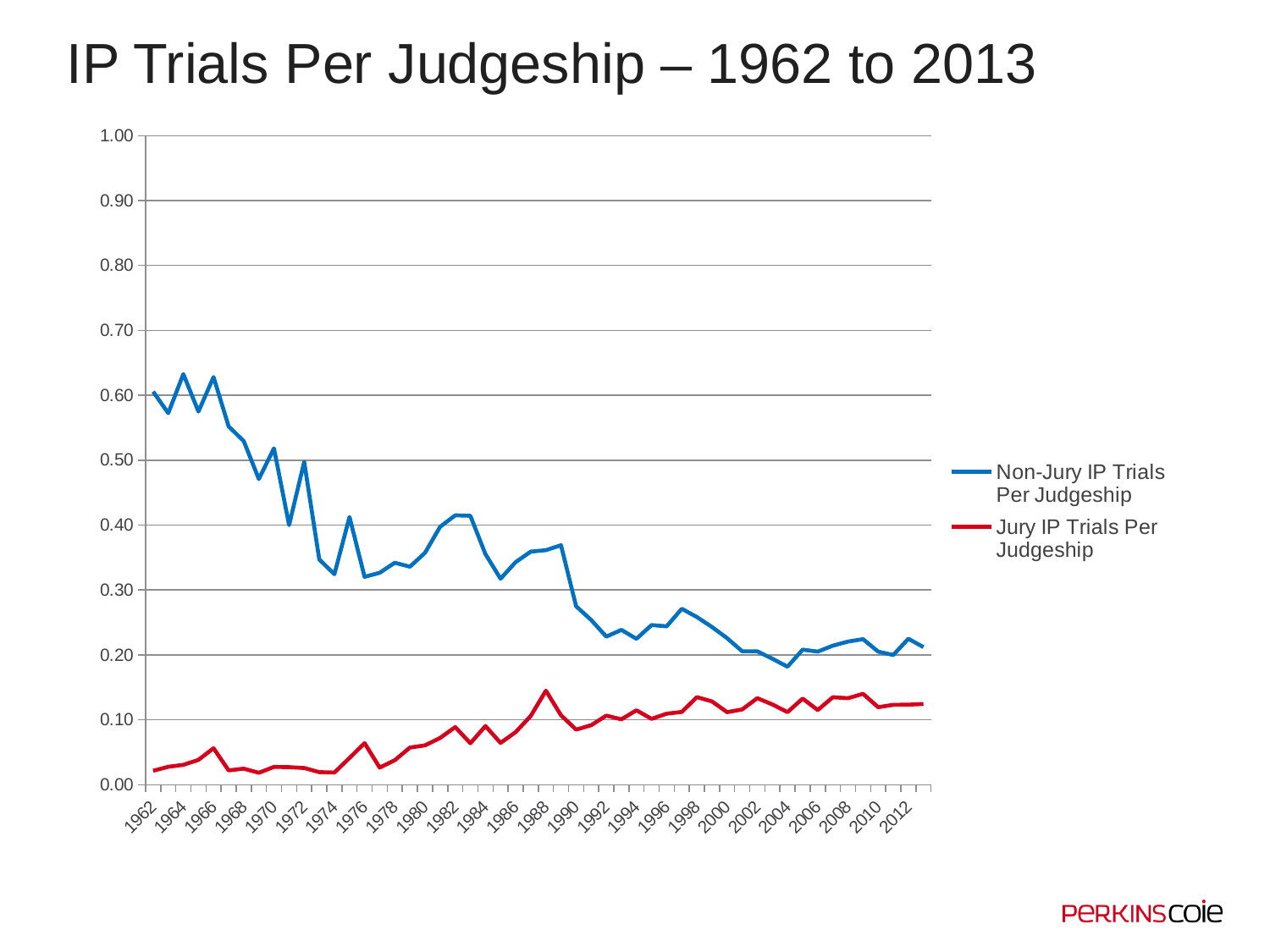
Do the values for Jury IP Trials Per Judgeship generally rise or fall from 1962 to 2013? Rise Is the value for Jury IP Trials Per Judgeship in 2012 greater or less than 0.10? greater Is the value for Jury IP Trials Per Judgeship in 1962 greater or less than 0.10? less What kind of chart is shown on the slide? Line chart Is the value for Non-Jury IP Trials Per Judgeship in 2012 greater or less than 0.30? less What is the title of the chart? IP Trials Per Judgeship – 1962 to 2013 How many series does the legend list? 2 In 1962, which series has the larger value: Non-Jury IP Trials Per Judgeship or Jury IP Trials Per Judgeship? Non-Jury IP Trials Per Judgeship In which year does the Jury IP Trials Per Judgeship line reach its highest value? 1988 Which colour is used for the Jury IP Trials Per Judgeship line? Red Do the values for Non-Jury IP Trials Per Judgeship generally rise or fall from 1962 to 2013? Fall